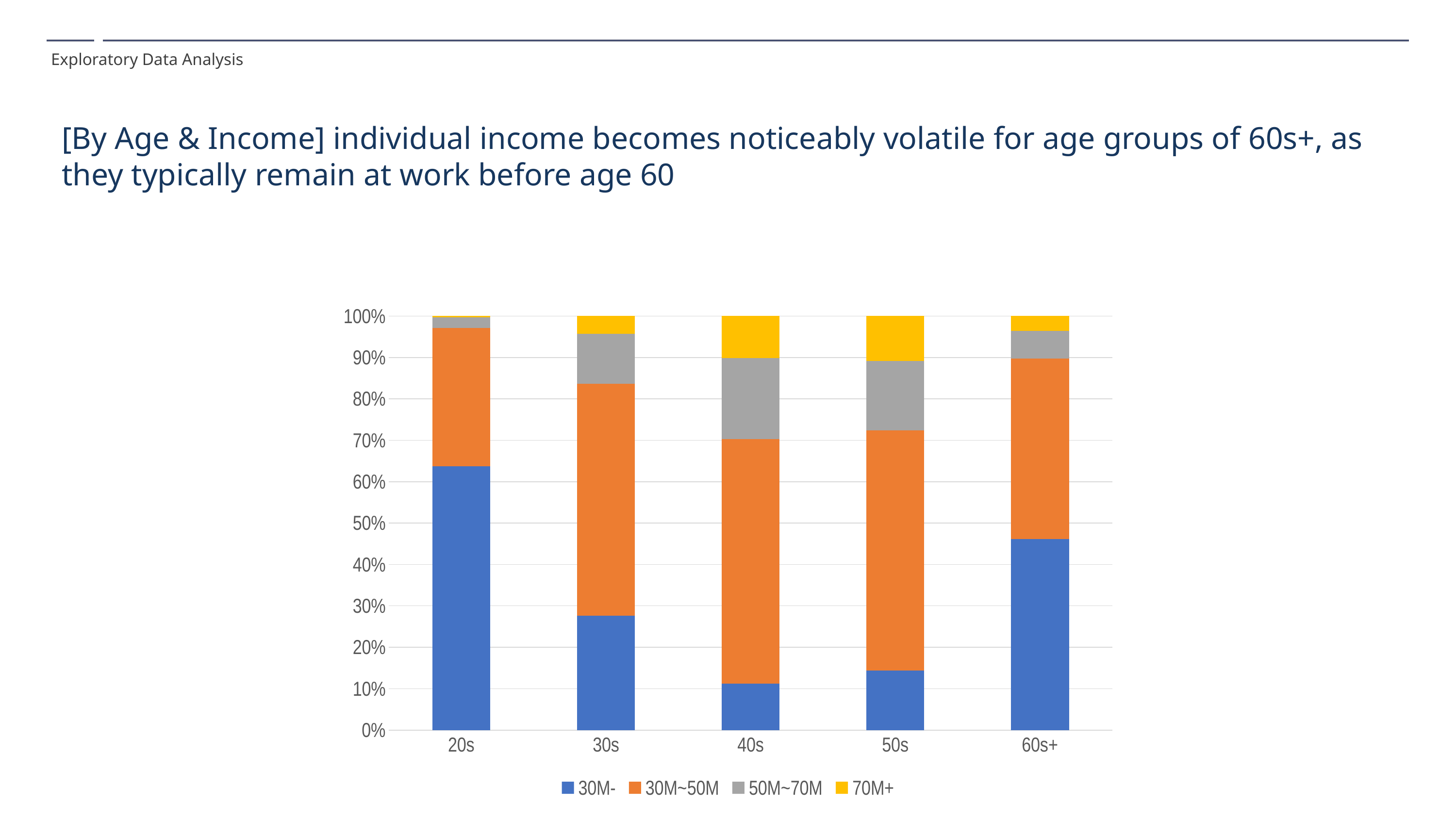
Which colour represents the 70M+ series in the legend? yellow What kind of chart is shown on the slide? stacked bar chart Is the 30M- share for the 60s+ group greater or less than 50%? less Which age group has the largest 30M- share? 20s Is the 30M- share for the 20s group greater or less than 60%? greater How many series does the legend list? 4 Which has the larger 30M- share, the 20s group or the 60s+ group? 20s Which age group has the smallest 70M+ share? 20s Which age group has the smallest 30M~50M share? 20s How many age groups are shown on the x axis? 5 Which age group has the smallest 30M- share? 40s Is the 30M- share for the 30s group greater or less than 30%? less